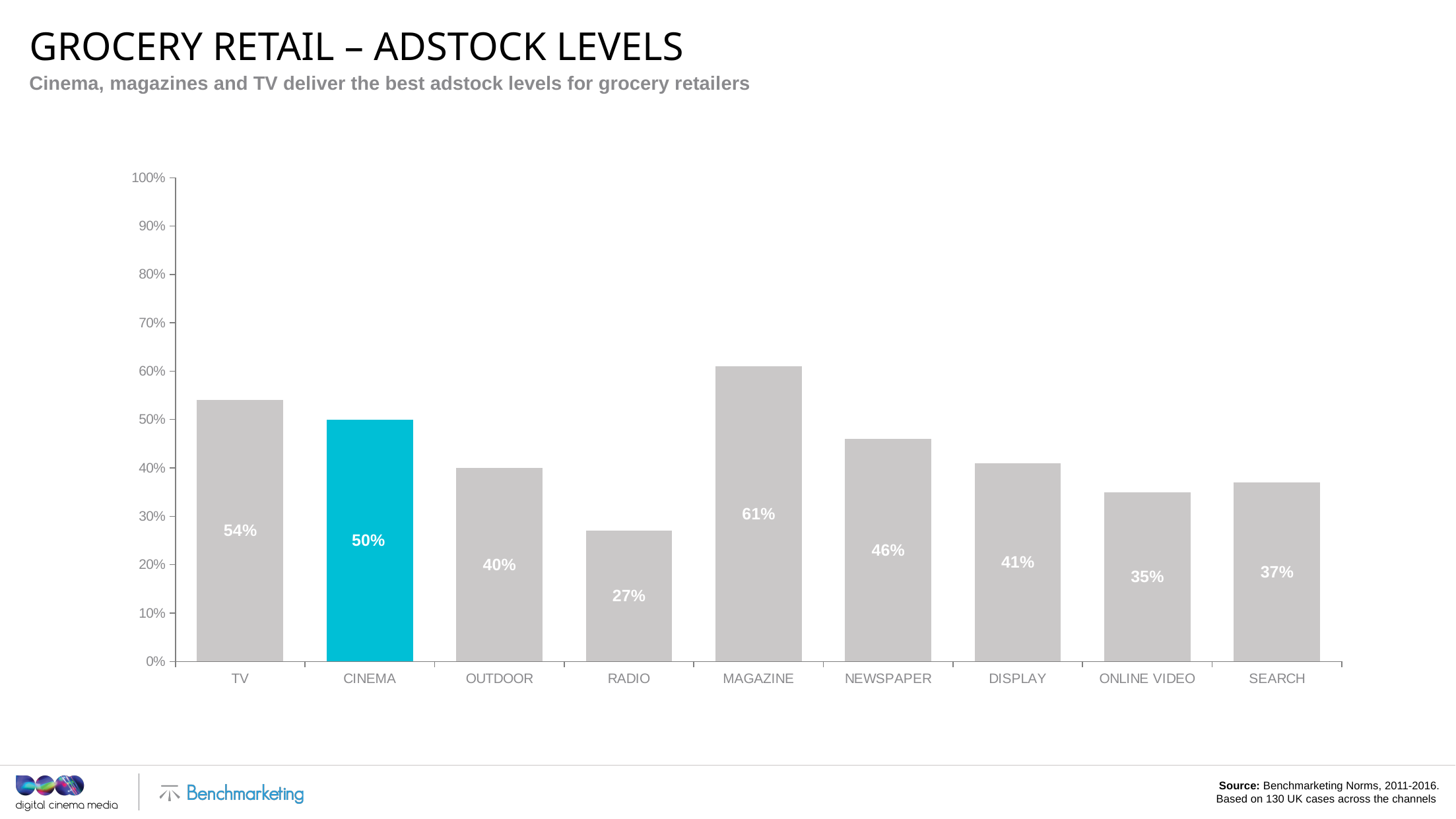
What is the adstock level for ONLINE VIDEO? 35% Which channel has the highest adstock level? MAGAZINE Which bar is highlighted in a different colour (blue) from the others? CINEMA What is the difference between the adstock levels for TV and CINEMA? 4% Which channel has the lowest adstock level? RADIO What is the difference between the adstock levels for MAGAZINE and RADIO? 34% Which has a higher adstock level, NEWSPAPER or DISPLAY? NEWSPAPER What kind of chart is shown on the slide? Bar chart How many channels are shown on the chart? 9 Is the value for OUTDOOR greater or less than 50%? less What is the adstock level for CINEMA? 50% What is the adstock level for MAGAZINE? 61%